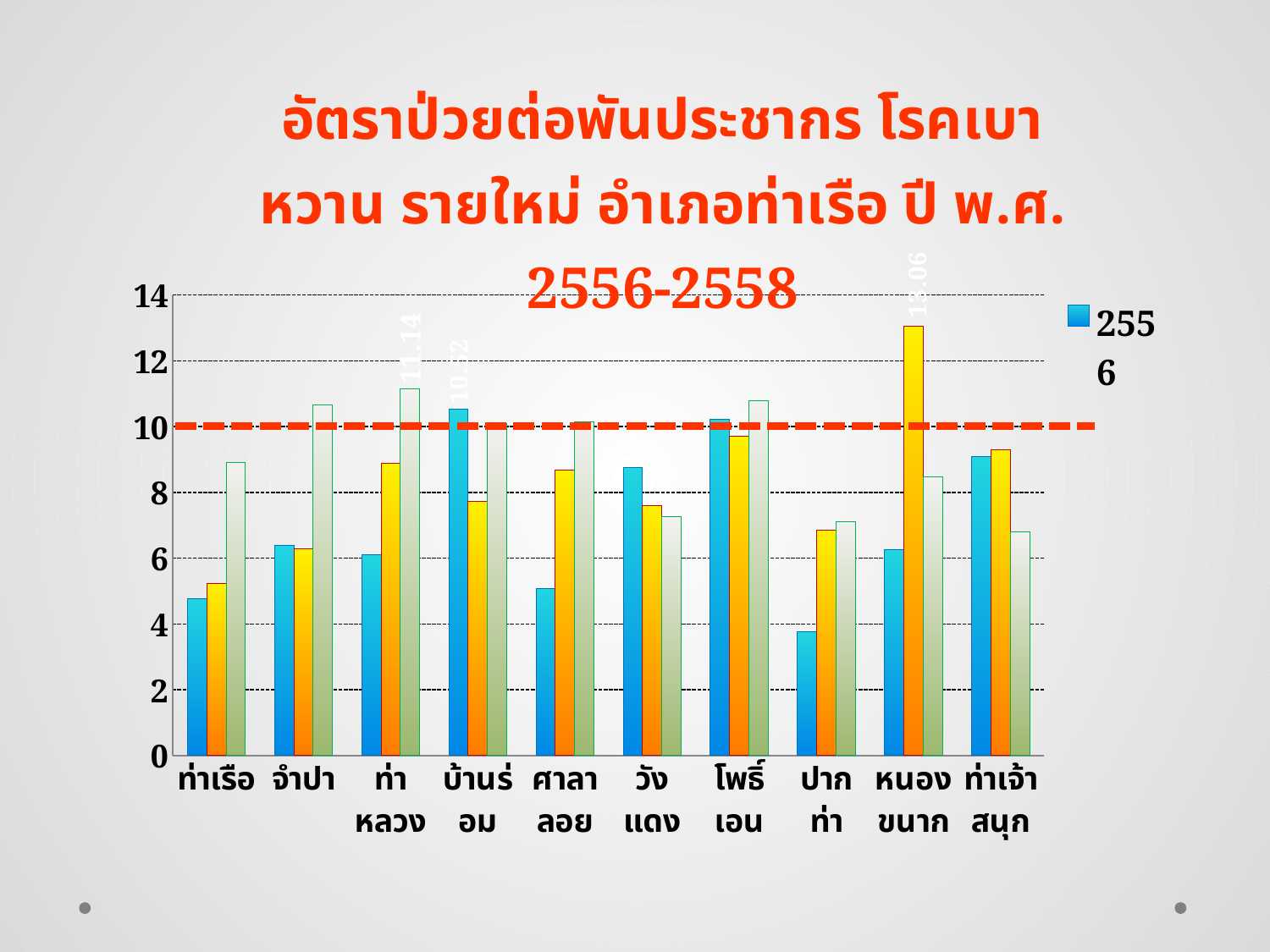
Is the value of the yellow bar for หนองขนาก greater or less than 12? greater Which is larger: the blue bar for ท่าเรือ or the blue bar for จำปา? จำปา Is the value of the blue bar for ท่าเรือ greater or less than 6? less What is the value of the data label shown above the tallest bar for ท่าหลวง? 11.14 What kind of chart is shown on the slide? bar chart What is the difference between the labelled value for หนองขนาก (13.06) and the labelled value for ท่าหลวง (11.14)? 1.92 How many categories (sub-districts) are shown on the x axis? 10 Which category has the highest bar in the chart? หนองขนาก What is the value of the data label shown above the tallest bar for หนองขนาก? 13.06 Which category has the lowest bar in the chart? ปากท่า At what value on the y axis is the red dashed horizontal line drawn? 10 How many bars are plotted for each category? 3